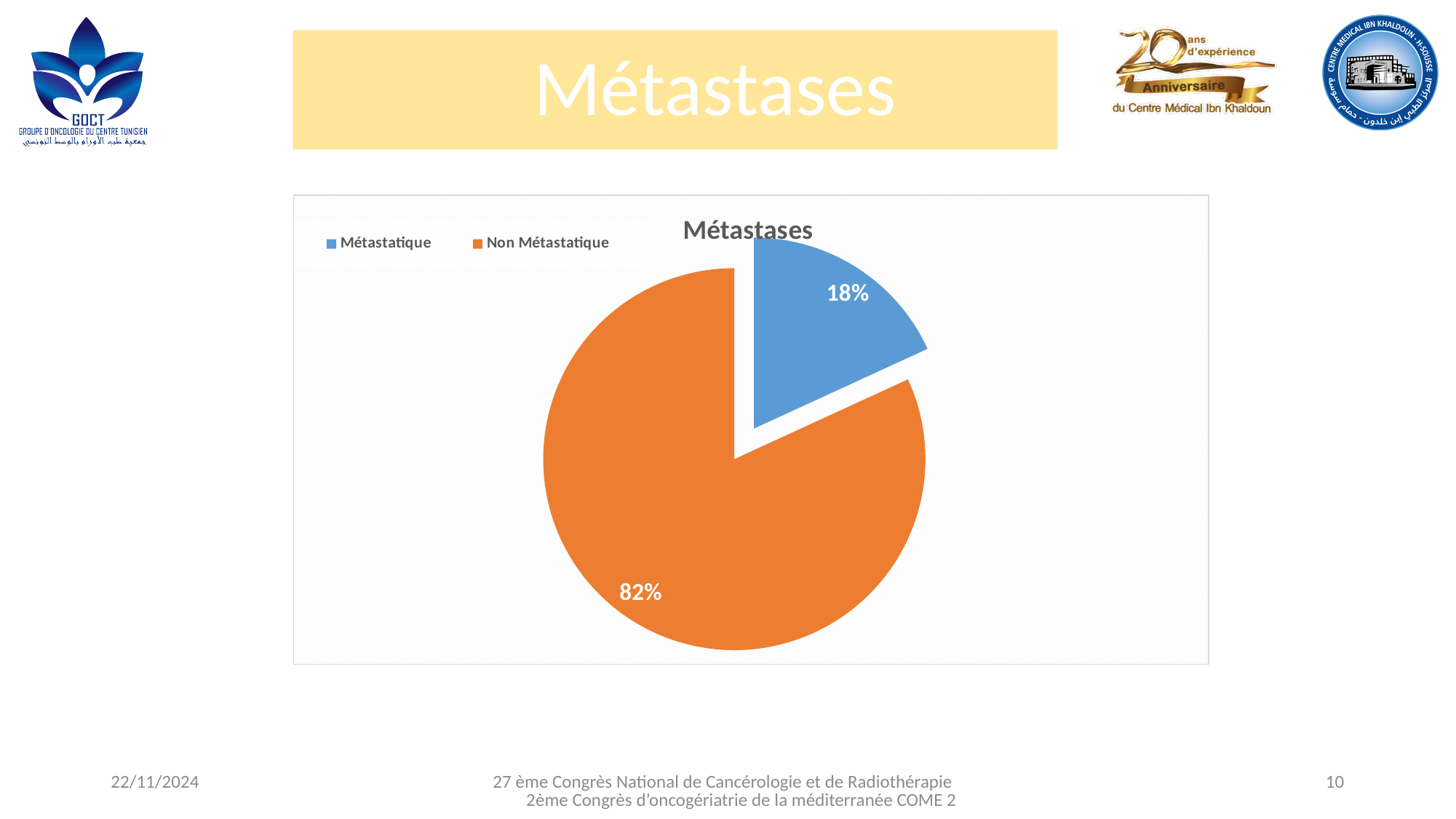
What percentage of the pie is Métastatique? 18% What is the chart's title? Métastases What kind of chart is shown on the slide? pie chart What percentage of the pie is Non Métastatique? 82% Which is larger, the Métastatique slice or the Non Métastatique slice? Non Métastatique How many slices does the pie chart have? 2 Which slice is the smallest? Métastatique What share of the pie does the Non Métastatique slice represent? 82% What colour is the Métastatique slice? blue How many entries does the legend list? 2 What is the difference in percentage points between Non Métastatique and Métastatique? 64 Which slice is the largest? Non Métastatique